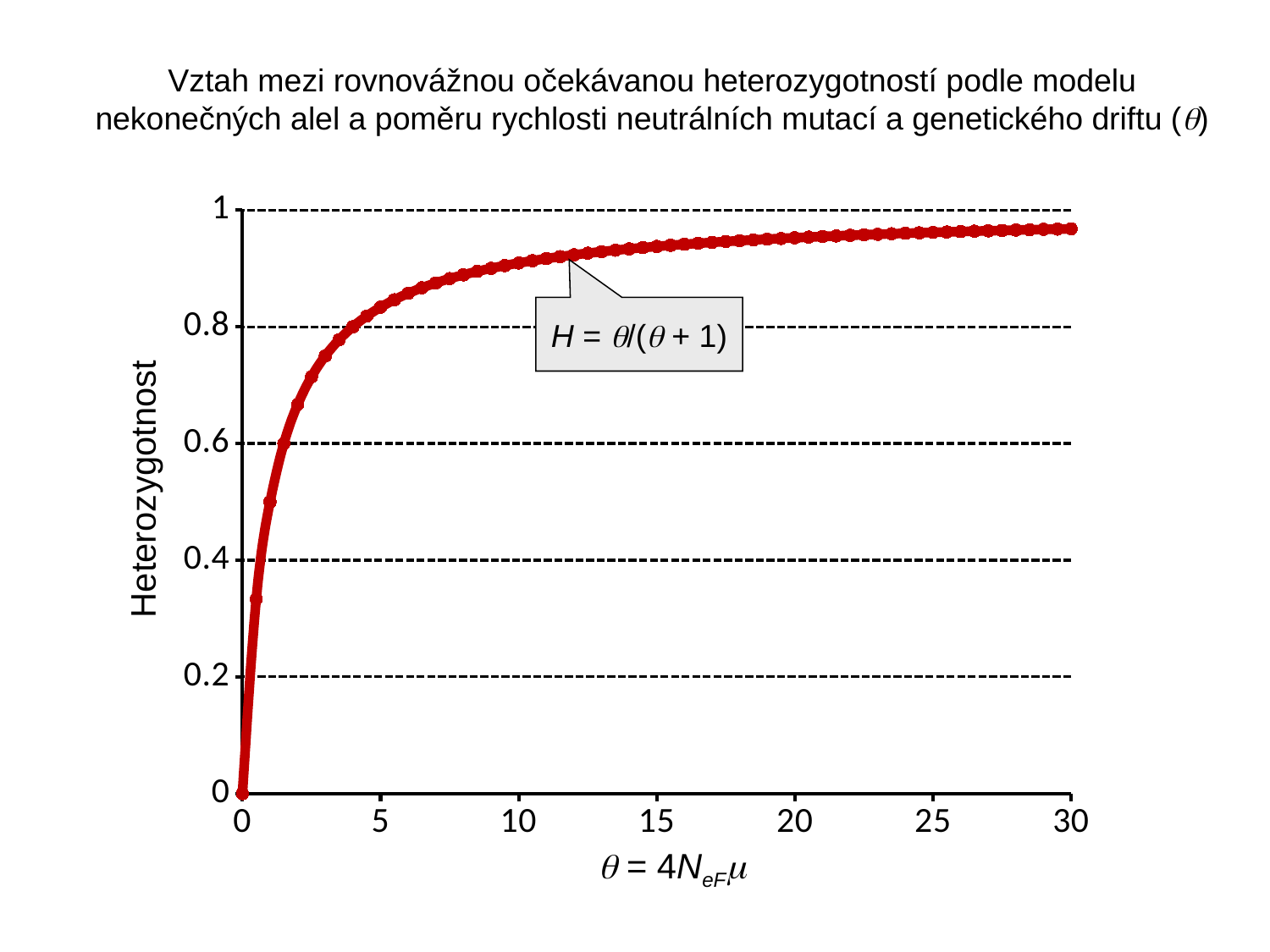
Does heterozygosity rise or fall as θ increases along the x axis? rises Is the heterozygosity at θ = 1 greater or less than 0.4? greater What is the maximum value shown on the x axis? 30 What formula is shown in the callout box on the chart? H = θ/(θ + 1) Is the heterozygosity at θ = 10 greater or less than 0.8? greater What is the heterozygosity value at θ = 0? 0 Is the heterozygosity at θ = 5 greater or less than 0.8? greater Which has the higher heterozygosity, θ = 5 or θ = 20? θ = 20 What is the label of the y axis? Heterozygotnost What kind of chart is shown on the slide? line chart